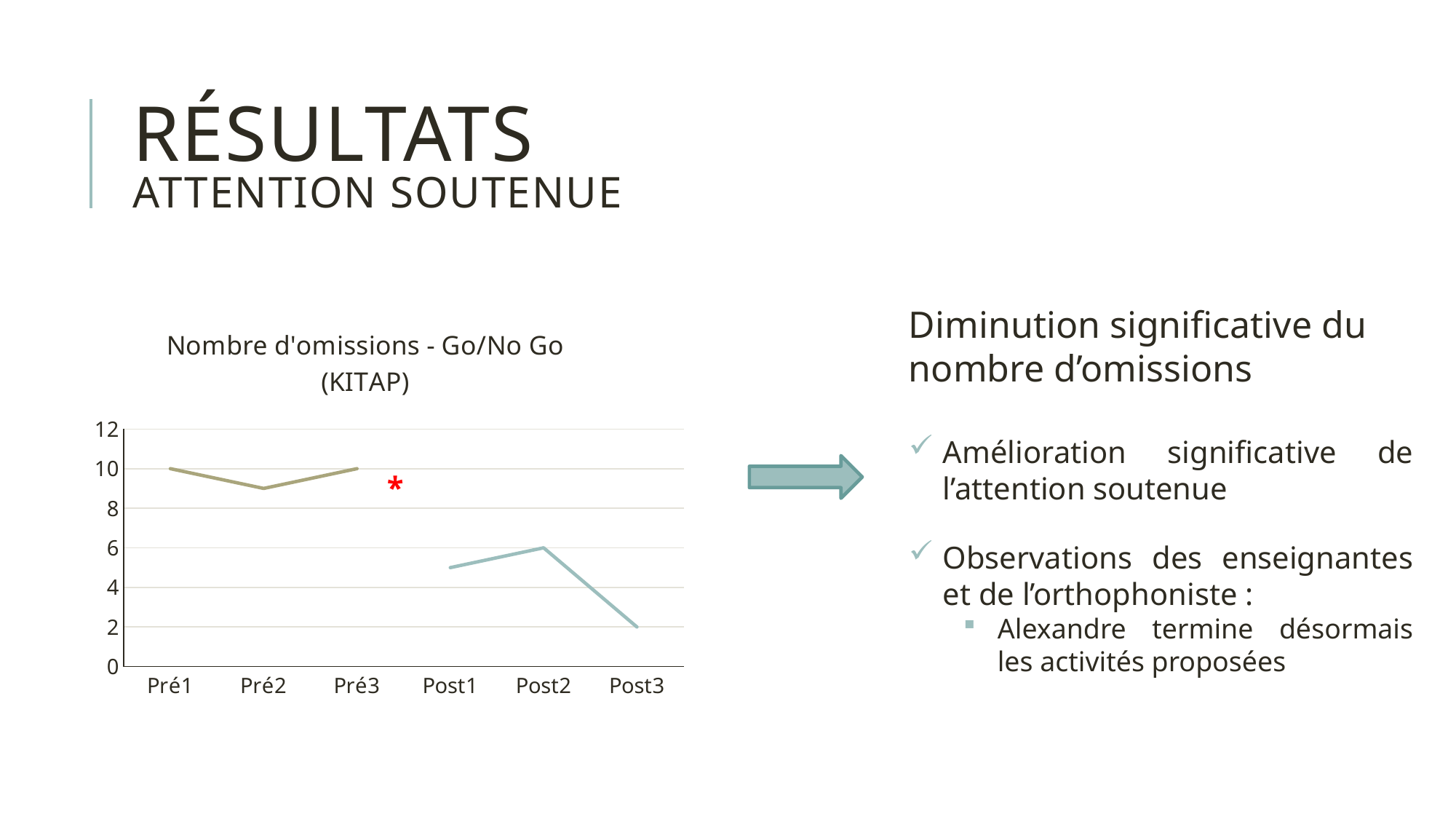
How many categories are shown on the x axis? 6 What kind of chart is shown on the slide? line chart What is the value for Pré1? 10 Is the value for Pré2 greater or less than 8? greater Which is larger, the value for Pré3 or the value for Post2? Pré3 What is the value for Post2? 6 What is the value for Post3? 2 What is the difference between the values for Pré1 and Post3? 8 Is the value for Post1 greater or less than 6? less Which category has the lowest value? Post3 What is the title of the chart? Nombre d'omissions - Go/No Go (KITAP) What is the value for Pré3? 10